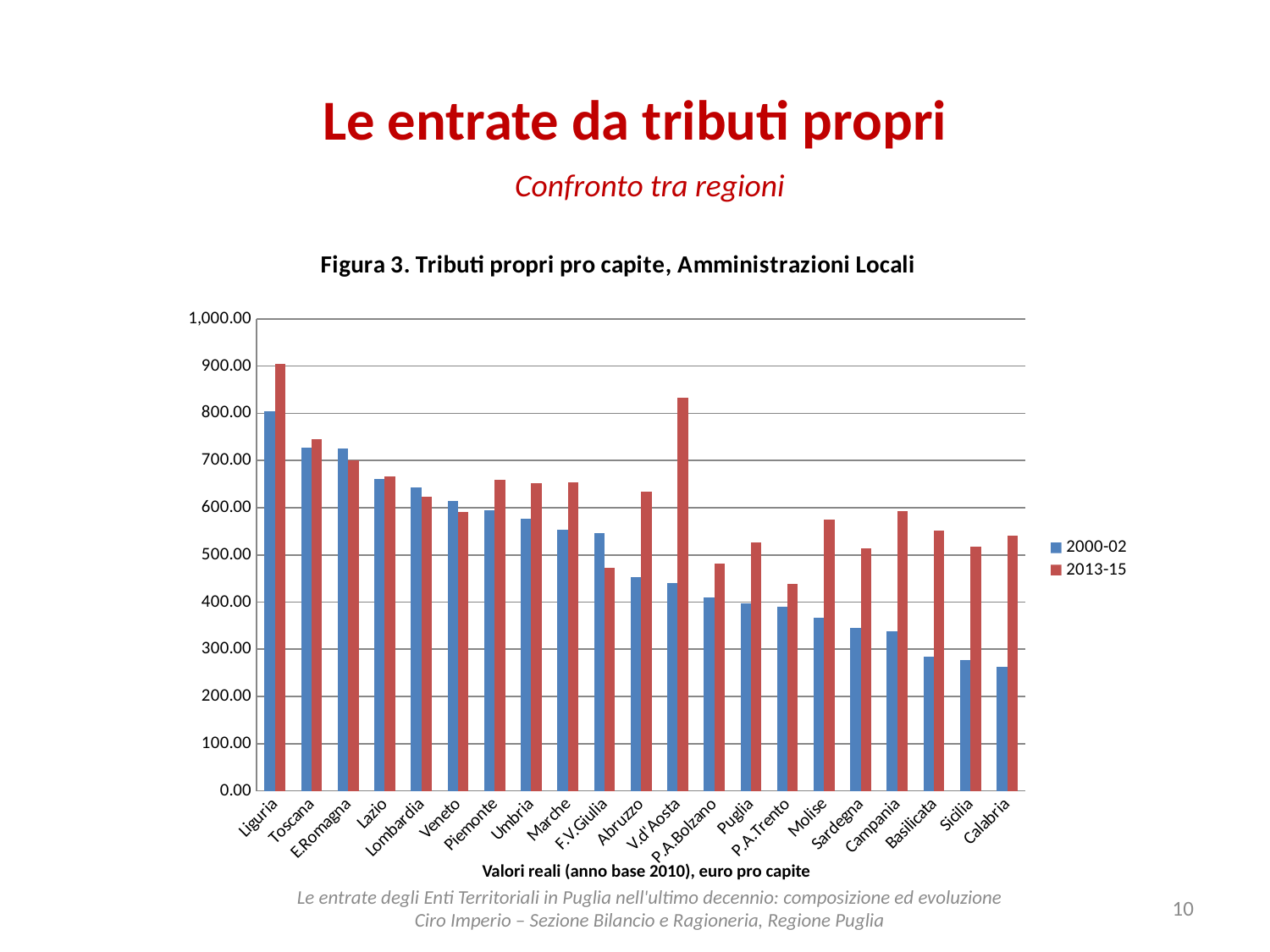
What is the title of the chart? Figura 3. Tributi propri pro capite, Amministrazioni Locali Is the 2000-02 value for Calabria greater or less than 300.00? less Which region has the highest value for the 2013-15 series? Liguria Which region has the highest value for the 2000-02 series? Liguria Which region has the lowest value for the 2000-02 series? Calabria How many regions are shown on the x axis? 21 What kind of chart is shown on the slide? bar chart Is the 2013-15 value for V.d'Aosta greater or less than 800.00? greater Is the 2013-15 value for Puglia greater or less than 500.00? greater Do the 2000-02 values generally rise or fall from left to right along the x axis? fall How many series does the legend list? 2 For Puglia, which series has the larger value, 2000-02 or 2013-15? 2013-15